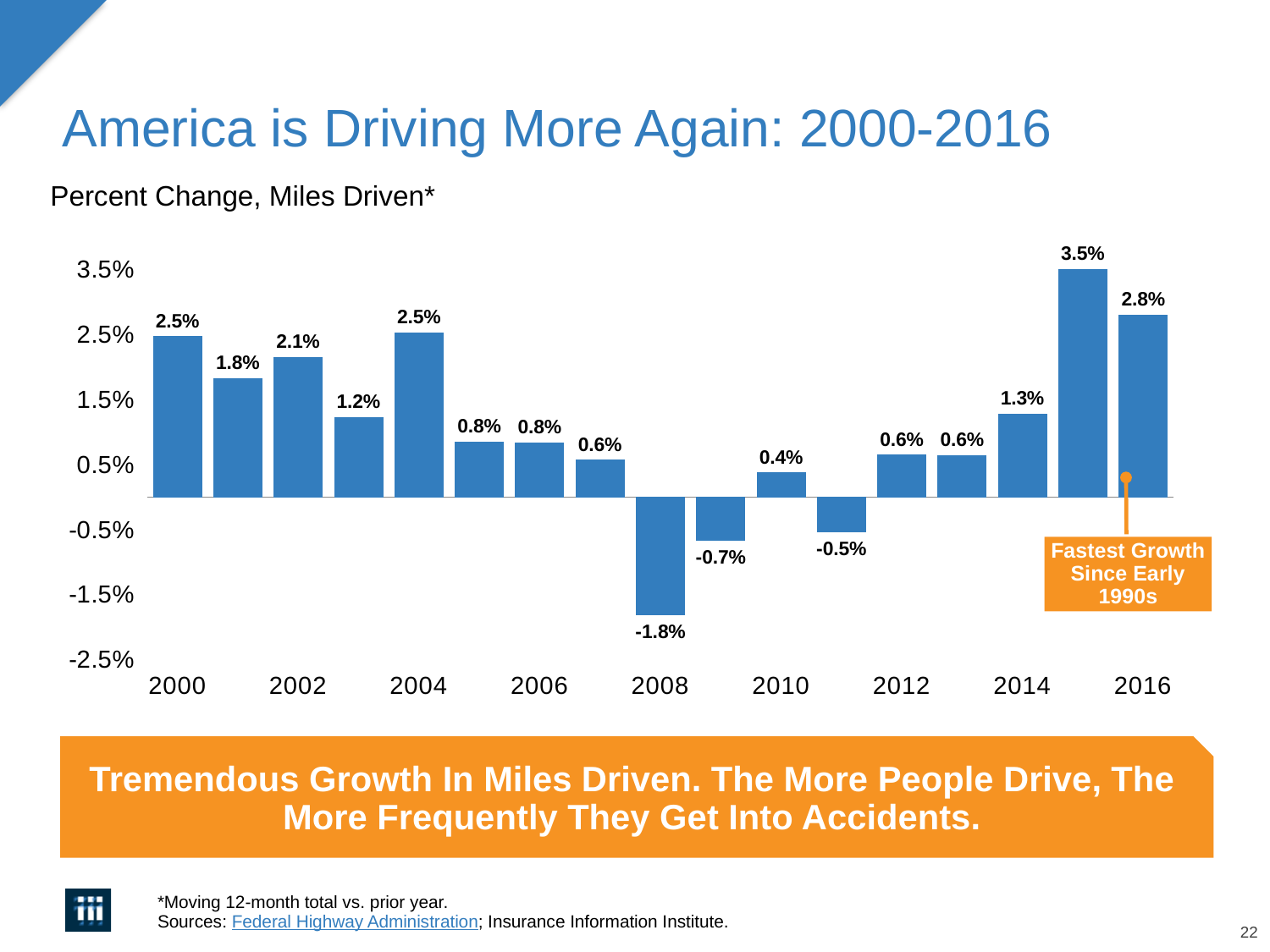
What is the difference between the percent change in 2016 and the percent change in 2014? 1.5% How many bars are plotted on the chart? 17 Which year has a larger percent change in miles driven, 2000 or 2012? 2000 What does the orange callout on the chart say about the 2016 bar? Fastest Growth Since Early 1990s Do the values rise or fall from 2014 to 2015? Rise What is the highest percent change shown on the chart? 3.5% Which year has the lowest percent change in miles driven? 2008 What is the percent change in miles driven for 2010? 0.4% What is the percent change in miles driven for 2004? 2.5% What is the percent change in miles driven for 2008? -1.8% What is the percent change in miles driven for 2016? 2.8% What kind of chart is shown on the slide? Bar chart